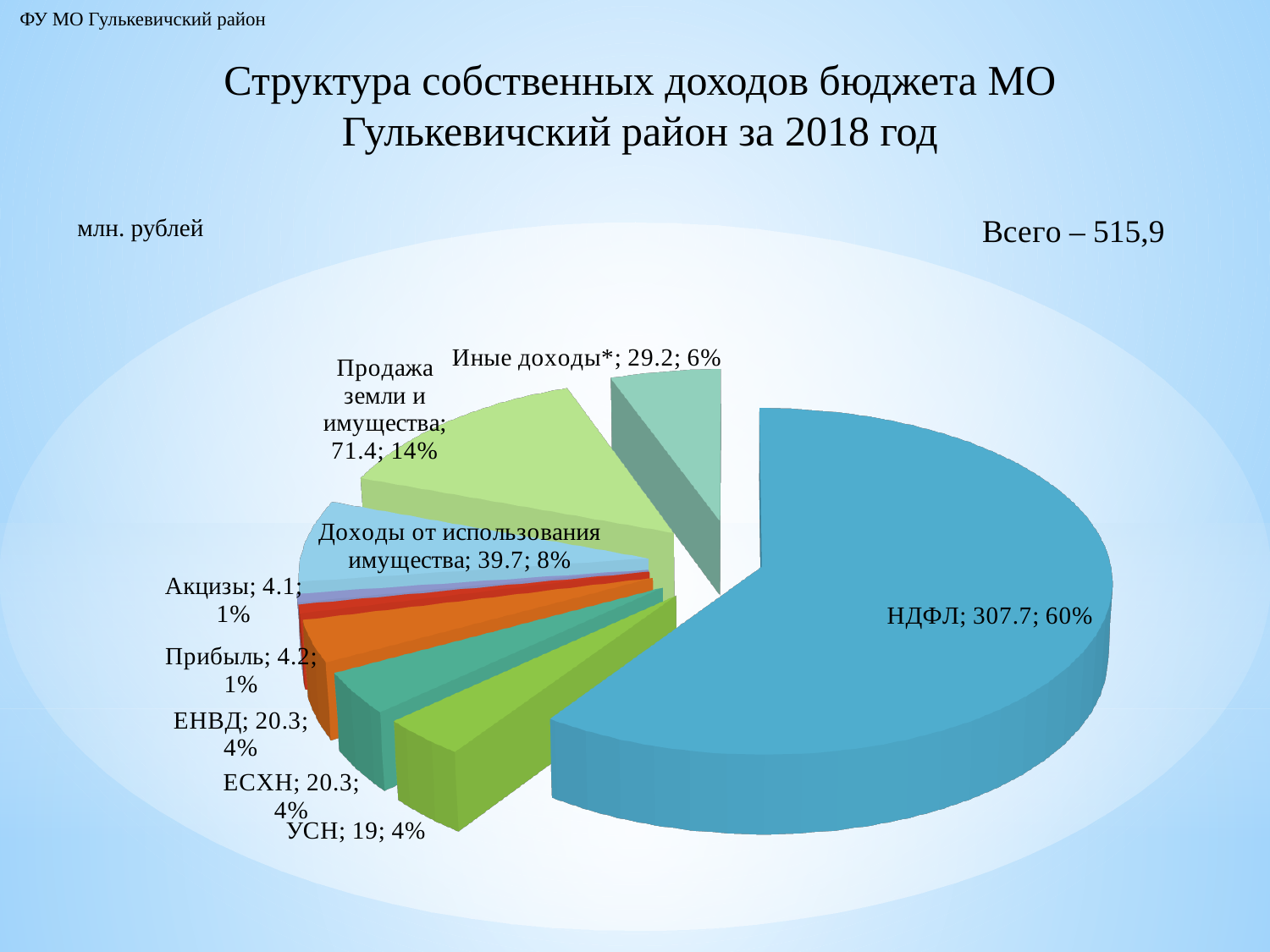
Which category has the smallest value? Акцизы What kind of chart is shown on the slide? pie chart What is the difference between the values for Продажа земли и имущества and Доходы от использования имущества? 31.7 What is the value for Продажа земли и имущества? 71.4 Which category has the largest slice? НДФЛ What is the value for Иные доходы*? 29.2 What total is stated on the slide for the chart? 515,9 Which is larger, the value for ЕНВД or the value for УСН? ЕНВД How many slices does the pie chart have? 9 What is the value for НДФЛ? 307.7 What share of the pie does Доходы от использования имущества represent? 8% What share of the pie does НДФЛ represent? 60%